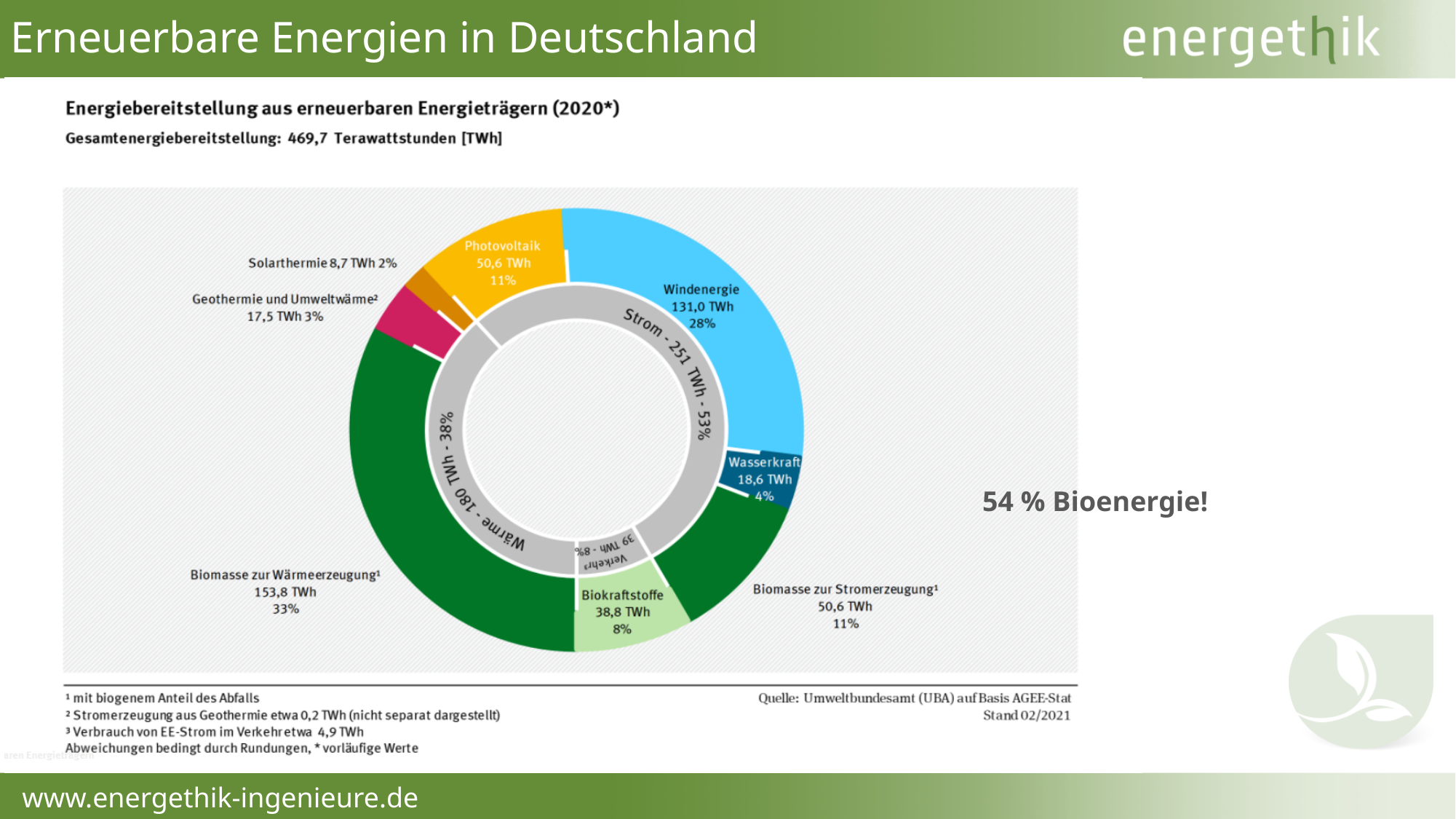
How many categories are shown in the outer ring of the chart? 8 Which category in the outer ring has the highest value? Biomasse zur Wärmeerzeugung What is the total energy provision stated above the chart? 469,7 TWh What is the value shown for Strom in the inner ring? 251 TWh What share of the total does Biomasse zur Wärmeerzeugung account for? 33% What is the value for Wasserkraft? 18,6 TWh What share does Verkehr account for in the inner ring? 8% Which category in the outer ring has the lowest value? Solarthermie Which is larger, Biokraftstoffe or Wasserkraft? Biokraftstoffe What is the value for Windenergie? 131,0 TWh What kind of chart is shown on the slide? Pie chart (donut) What is the difference in TWh between Windenergie and Photovoltaik? 80,4 TWh